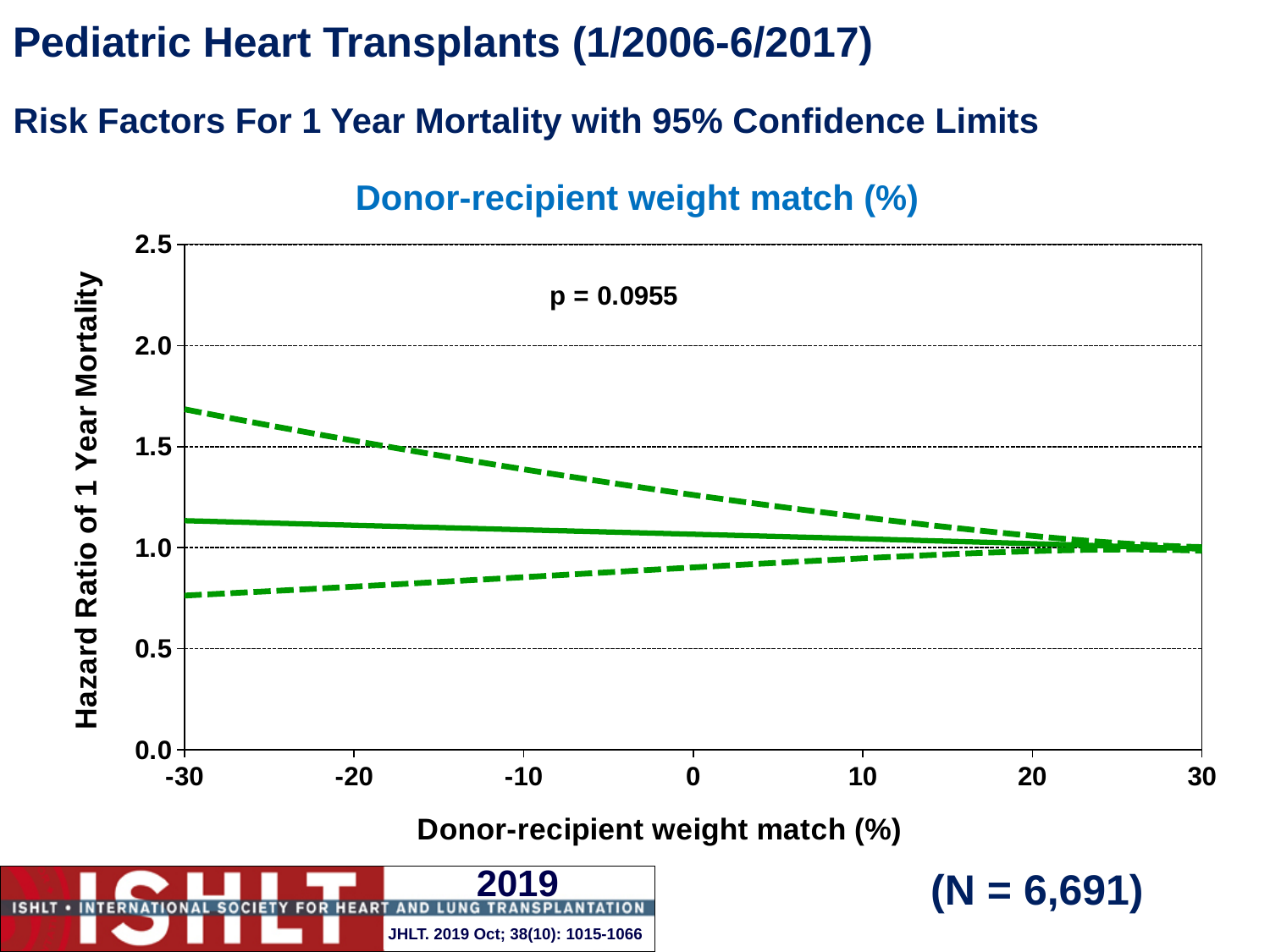
What kind of chart is shown on the slide? line chart How many lines are plotted on the chart? 3 Does the solid hazard ratio line rise or fall as donor-recipient weight match increases from -30 to 30? fall Is the lower dashed confidence limit at a weight match of -30 greater or less than 1.0? less Does the lower dashed confidence limit rise or fall as donor-recipient weight match increases from -30 to 30? rise Is the upper dashed confidence limit at a weight match of -30 greater or less than 1.5? greater What is the title of the chart? Donor-recipient weight match (%) Is the solid hazard ratio line at a weight match of -30 greater or less than 1.0? greater What is the label of the y axis? Hazard Ratio of 1 Year Mortality Does the upper dashed confidence limit rise or fall as donor-recipient weight match increases from -30 to 30? fall What p-value is printed on the chart? p = 0.0955 What is the sample size (N) shown on the slide? 6,691